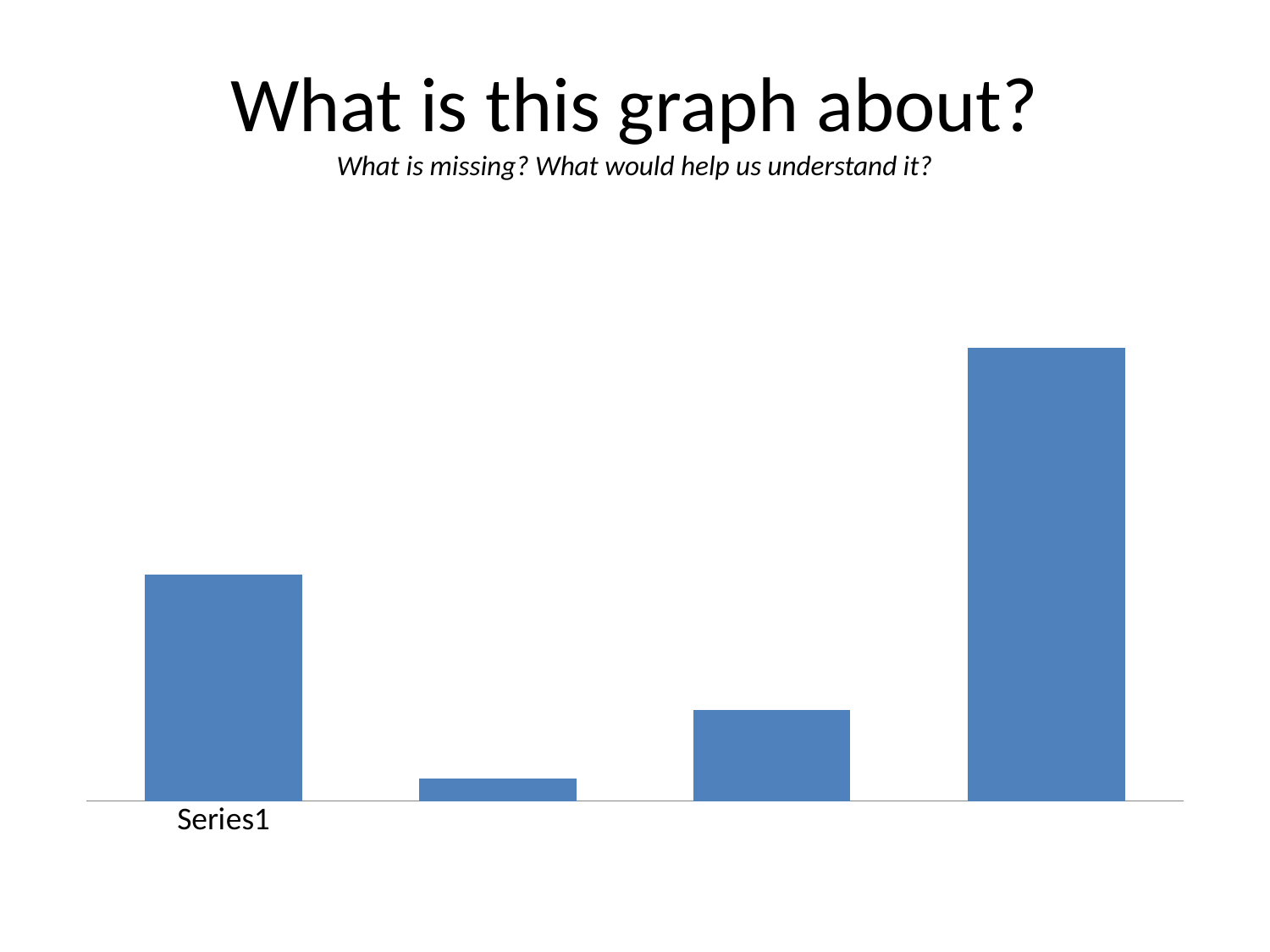
Do the bar heights rise or fall from the third bar to the fourth bar? rise Which is taller, the first bar or the third bar? the first bar Which bar is the shortest in the chart, counting from the left? the second bar Do the bar heights rise or fall from the first bar to the second bar? fall What kind of chart is shown on the slide? bar chart Which is taller, the third bar or the second bar? the third bar Which bar is the tallest in the chart, counting from the left? the fourth bar What is the only label shown on the horizontal axis of the chart? Series1 How many bars are plotted in the chart? 4 Which is taller, the first bar or the fourth bar? the fourth bar What colour are the bars in the chart? blue